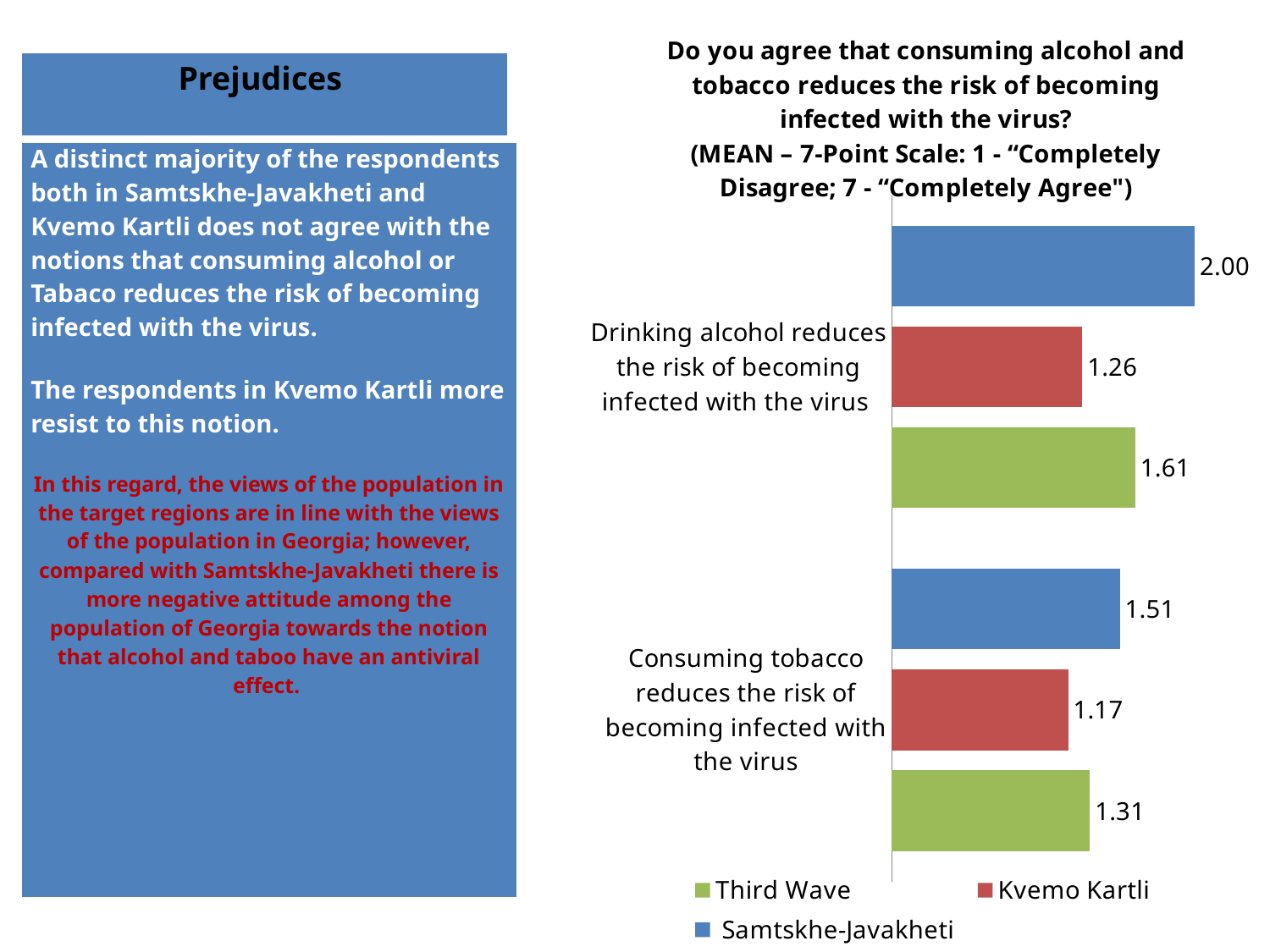
What is the Samtskhe-Javakheti value for "Drinking alcohol reduces the risk of becoming infected with the virus"? 2.00 What is the difference between the Third Wave values for the alcohol statement and the tobacco statement? 0.30 Which series has the highest value for "Drinking alcohol reduces the risk of becoming infected with the virus"? Samtskhe-Javakheti Which is larger: the Kvemo Kartli value for the alcohol statement or the Kvemo Kartli value for the tobacco statement? The alcohol statement (1.26) What type of chart is shown on the slide? Bar chart Which series has the lowest value for "Consuming tobacco reduces the risk of becoming infected with the virus"? Kvemo Kartli How many statements (categories) are shown on the chart? 2 What is the Kvemo Kartli value for "Consuming tobacco reduces the risk of becoming infected with the virus"? 1.17 What is the Samtskhe-Javakheti value for "Consuming tobacco reduces the risk of becoming infected with the virus"? 1.51 What is the difference between the Samtskhe-Javakheti and Kvemo Kartli values for "Drinking alcohol reduces the risk of becoming infected with the virus"? 0.74 How many series does the legend list? 3 What is the Third Wave value for "Drinking alcohol reduces the risk of becoming infected with the virus"? 1.61